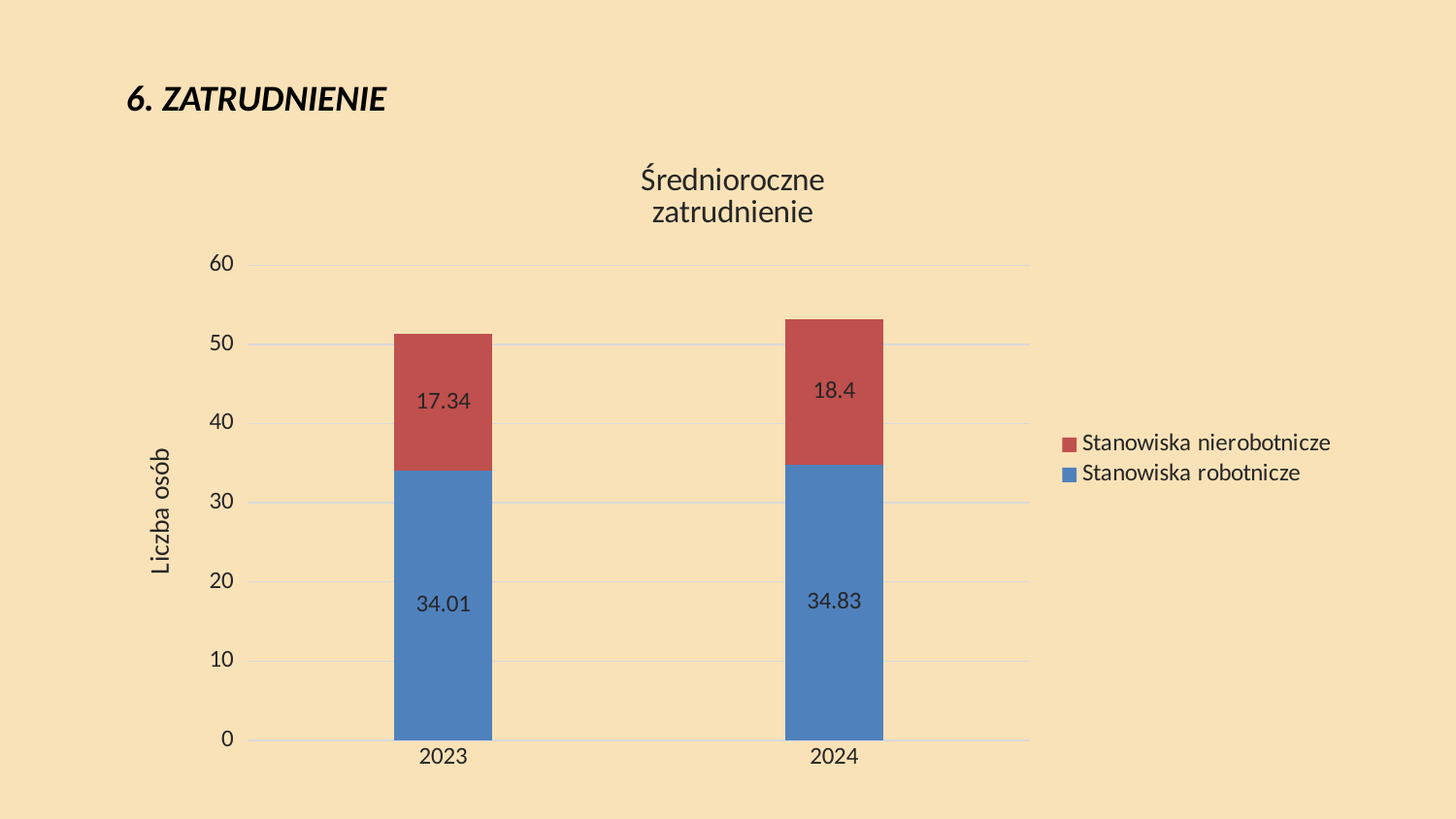
What is the total of the stacked bar for 2023? 51.35 How many categories are shown on the x axis? 2 What is the value for Stanowiska robotnicze in 2024? 34.83 What is the total of the stacked bar for 2024? 53.23 How many series does the legend list? 2 What is the value for Stanowiska robotnicze in 2023? 34.01 Is the total of the 2024 bar greater or less than 50? greater What is the difference between the Stanowiska nierobotnicze values for 2024 and 2023? 1.06 What kind of chart is shown? stacked bar chart What is the value for Stanowiska nierobotnicze in 2024? 18.4 Which is larger: Stanowiska robotnicze in 2023 or Stanowiska nierobotnicze in 2023? Stanowiska robotnicze in 2023 What is the value for Stanowiska nierobotnicze in 2023? 17.34